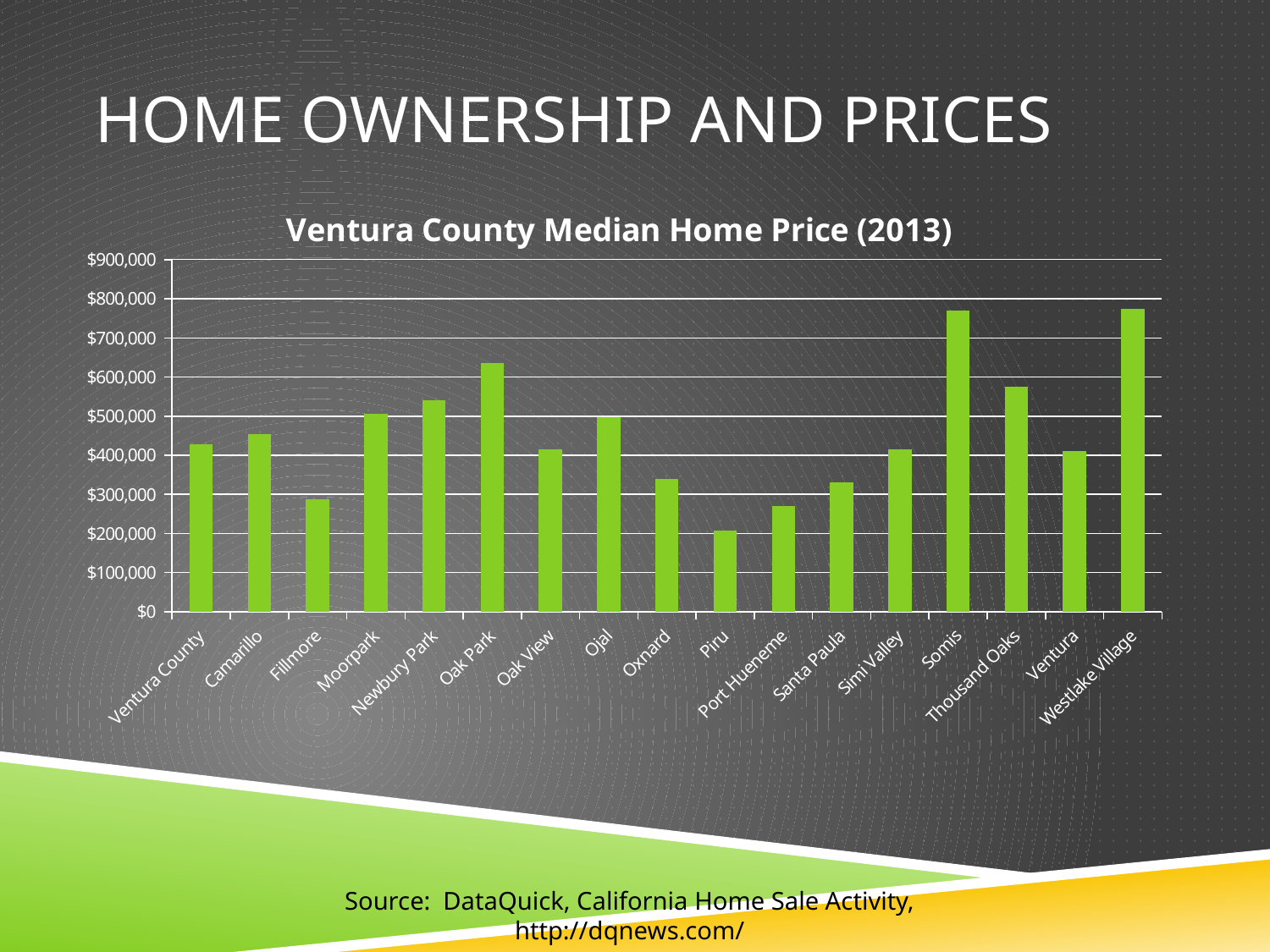
Which has a higher median home price, Port Hueneme or Moorpark? Moorpark Is the value for Somis greater or less than $700,000? greater How many categories are shown on the x axis of the chart? 17 What kind of chart is shown on the slide? Bar chart What is the title of the chart? Ventura County Median Home Price (2013) Which has a higher median home price, Oak Park or Oxnard? Oak Park Is the value for Piru greater or less than $300,000? less Which category has the lowest median home price? Piru Is the value for Thousand Oaks greater or less than $500,000? greater What is the highest value shown on the y axis of the chart? $900,000